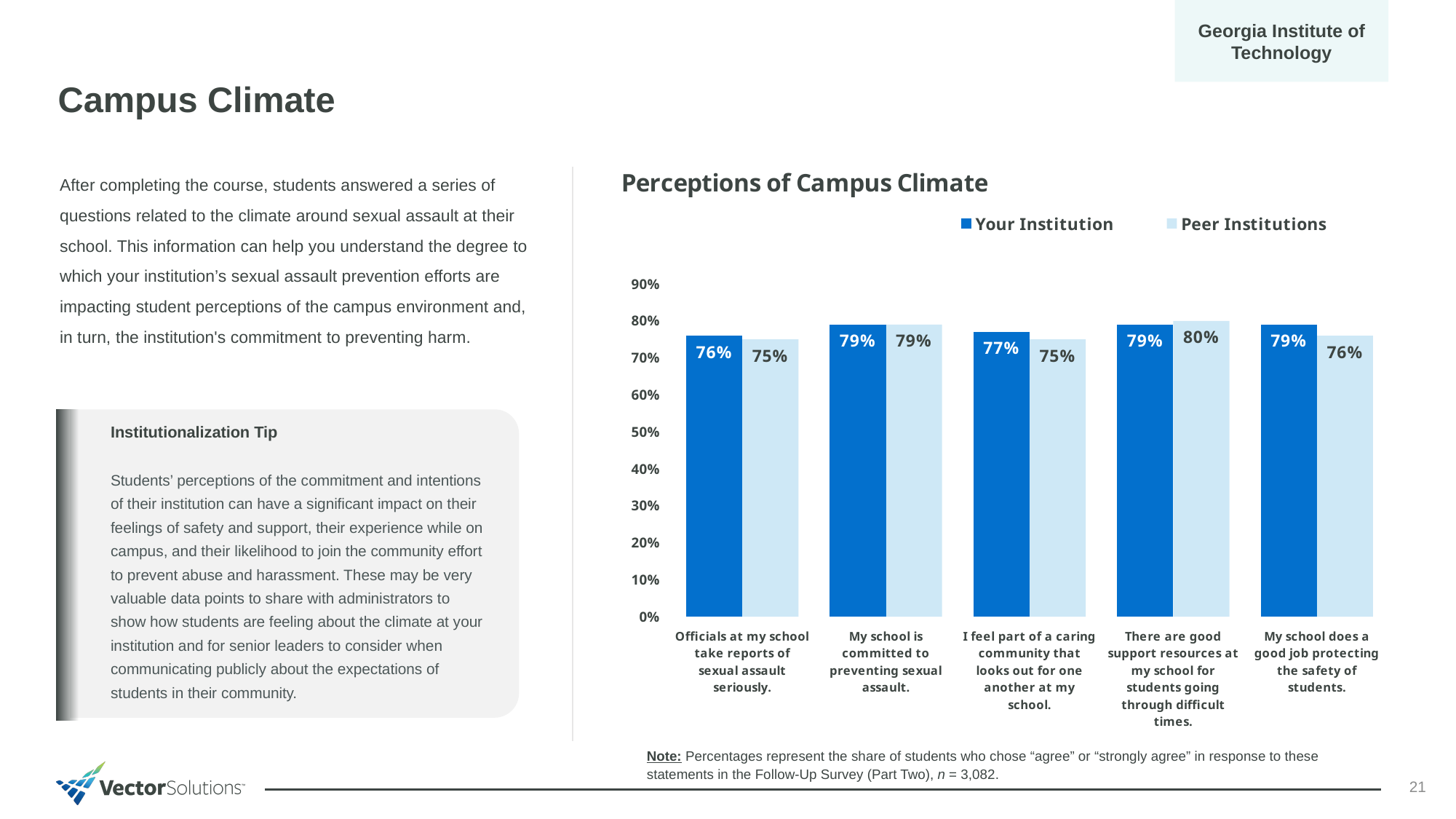
Which category has the lowest Your Institution value? Officials at my school take reports of sexual assault seriously. Which category has the highest Peer Institutions value? There are good support resources at my school for students going through difficult times. What type of chart is shown on the slide? Bar chart What is the Your Institution value for "Officials at my school take reports of sexual assault seriously"? 76% What is the Peer Institutions value for "There are good support resources at my school for students going through difficult times"? 80% What is the difference between the Your Institution and Peer Institutions values for "My school does a good job protecting the safety of students"? 3% How many categories are shown on the x axis of the chart? 5 What is the title of the chart? Perceptions of Campus Climate For "I feel part of a caring community that looks out for one another at my school", which is larger: Your Institution or Peer Institutions? Your Institution What is the Your Institution value for "My school does a good job protecting the safety of students"? 79% What is the Peer Institutions value for "I feel part of a caring community that looks out for one another at my school"? 75% How many series does the legend list? 2